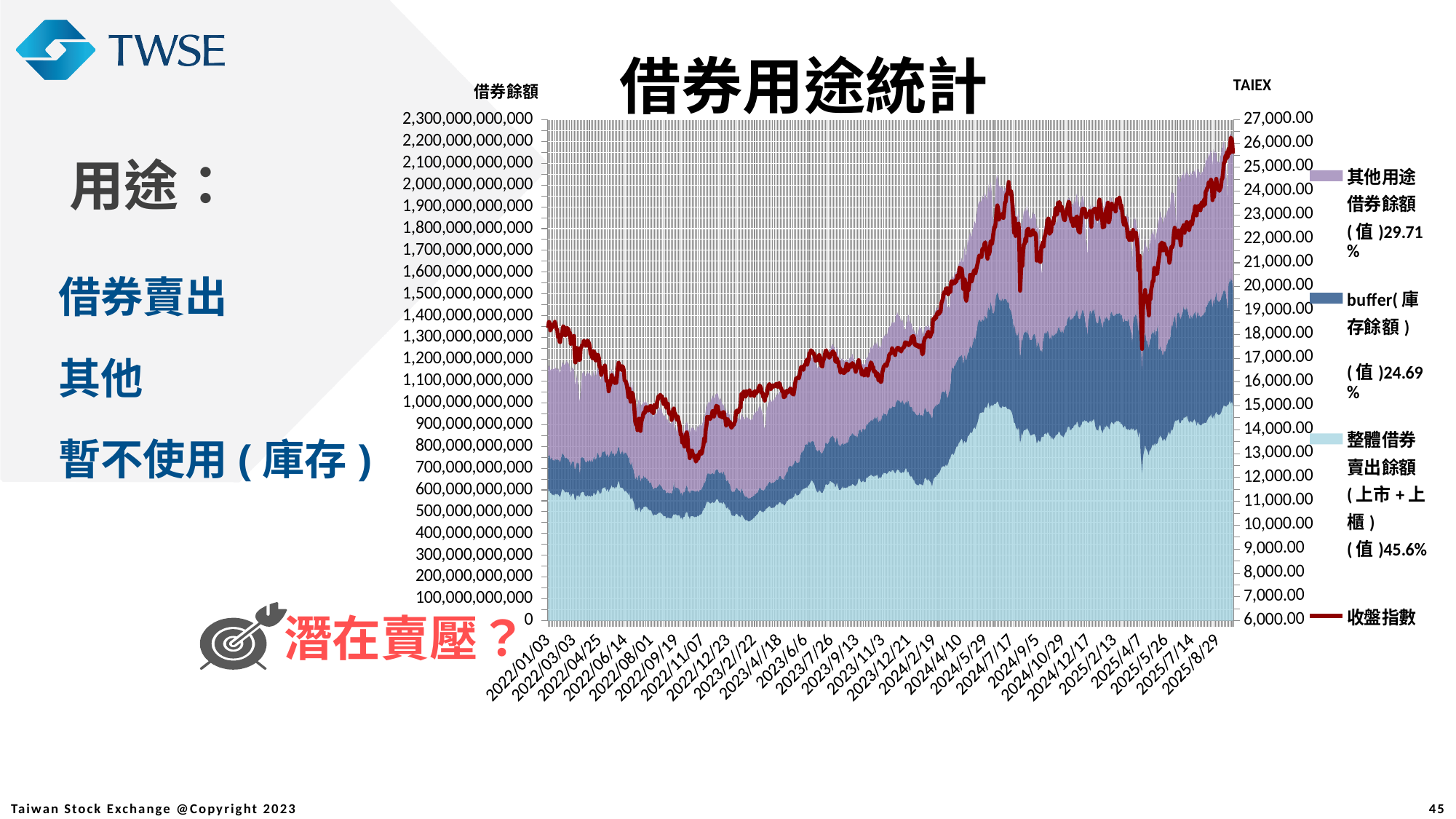
What percentage value is shown in the legend for 其他用途借券餘額? 29.71% What is the title of the chart? 借券用途統計 According to the legend percentages, which series has the smallest share? buffer(庫存餘額) Which legend share is larger: 其他用途借券餘額 or buffer(庫存餘額)? 其他用途借券餘額 Does the 收盤指數 line generally rise or fall from 2022/01/03 to 2025/8/29? Rise What percentage value is shown in the legend for 整體借券賣出餘額(上市+上櫃)? 45.6% What kind of chart is shown on the slide? A stacked area chart with a line overlay How many series does the legend list? 4 According to the legend percentages, which series has the largest share? 整體借券賣出餘額(上市+上櫃) What is the difference in percentage points between the legend shares of 整體借券賣出餘額(上市+上櫃) and 其他用途借券餘額? 15.89 What percentage value is shown in the legend for buffer(庫存餘額)? 24.69%